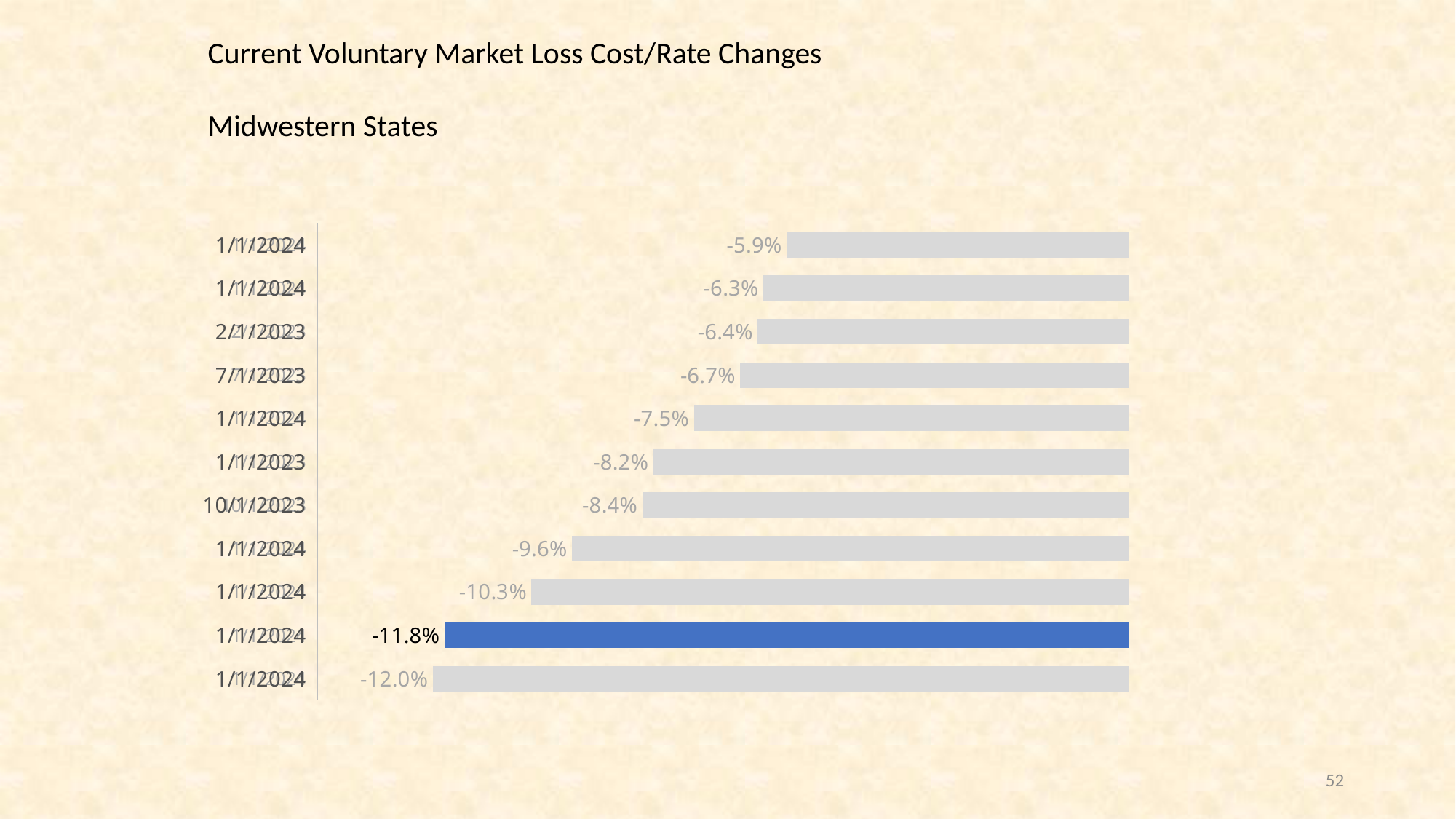
What is the lowest (most negative) value shown in the chart? -12.0% Do the bar values decrease from the top bar to the bottom bar? yes What is the value shown on the blue highlighted bar? -11.8% Which is larger, the value of the blue bar or the value of the bottom bar? the blue bar (-11.8%) What kind of chart is shown on the slide? bar chart What is the title of the slide above the chart? Current Voluntary Market Loss Cost/Rate Changes What is the value of the bottom bar in the chart? -12.0% What is the difference between the topmost bar's value (-5.9%) and the bottom bar's value (-12.0%)? 6.1 percentage points How many bars are plotted in the chart? 11 What is the difference between the blue bar's value (-11.8%) and the bottom bar's value (-12.0%)? 0.2 percentage points What is the value of the topmost bar in the chart? -5.9% What is the highest (least negative) value shown in the chart? -5.9%